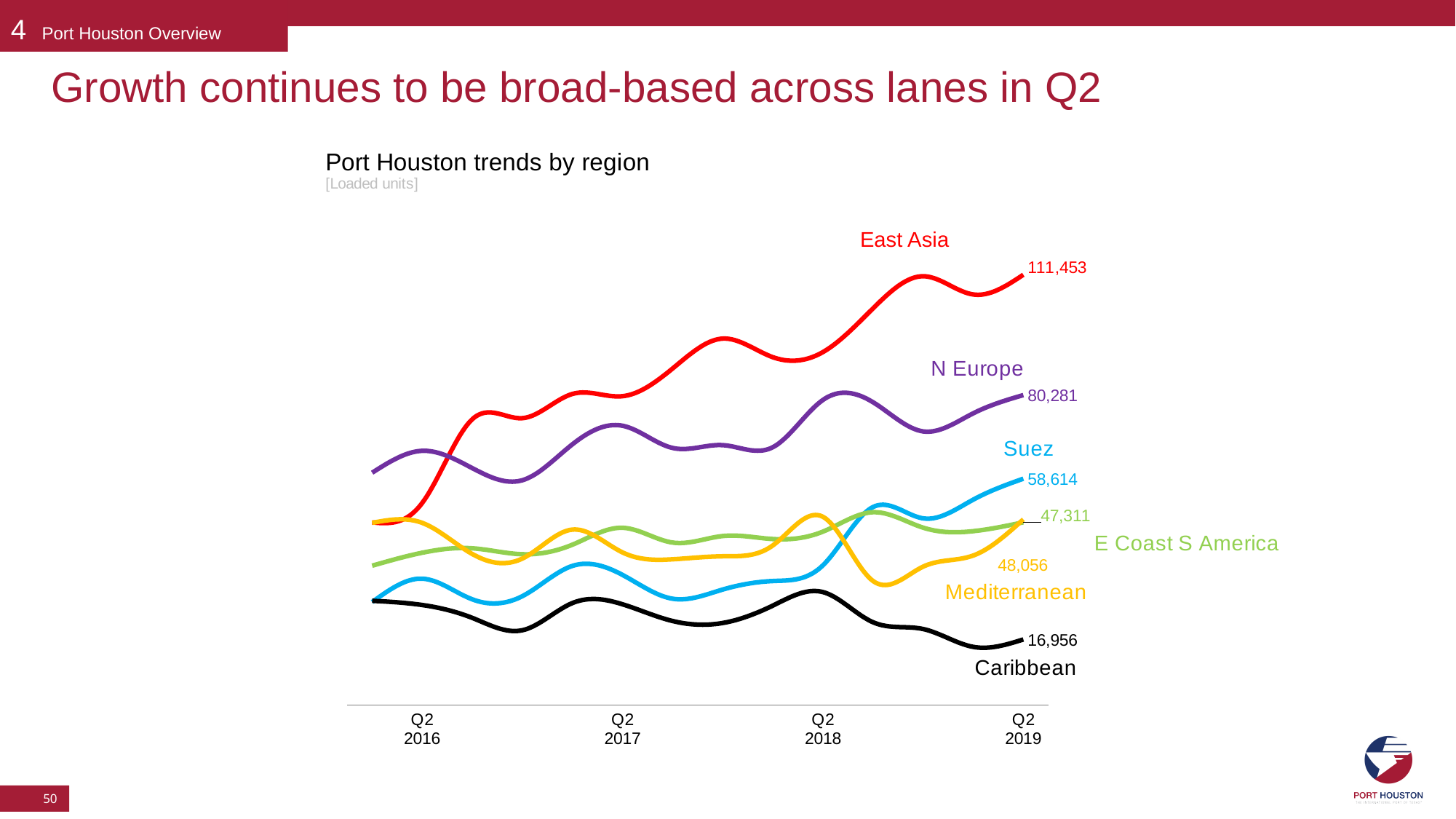
What kind of chart is shown on the slide? line chart Does the East Asia line rise or fall from Q2 2016 to Q2 2019? rises What is the value for Caribbean at Q2 2019? 16,956 Which region has the lowest value at Q2 2019? Caribbean What is the value for East Asia at Q2 2019? 111,453 How many regions are plotted on the chart? 6 What is the value for Suez at Q2 2019? 58,614 At Q2 2019, which is larger: Suez or N Europe? N Europe Which region has the highest value at Q2 2019? East Asia What is the value for Mediterranean at Q2 2019? 48,056 What is the difference between the East Asia and N Europe values at Q2 2019? 31,172 What is the value for N Europe at Q2 2019? 80,281